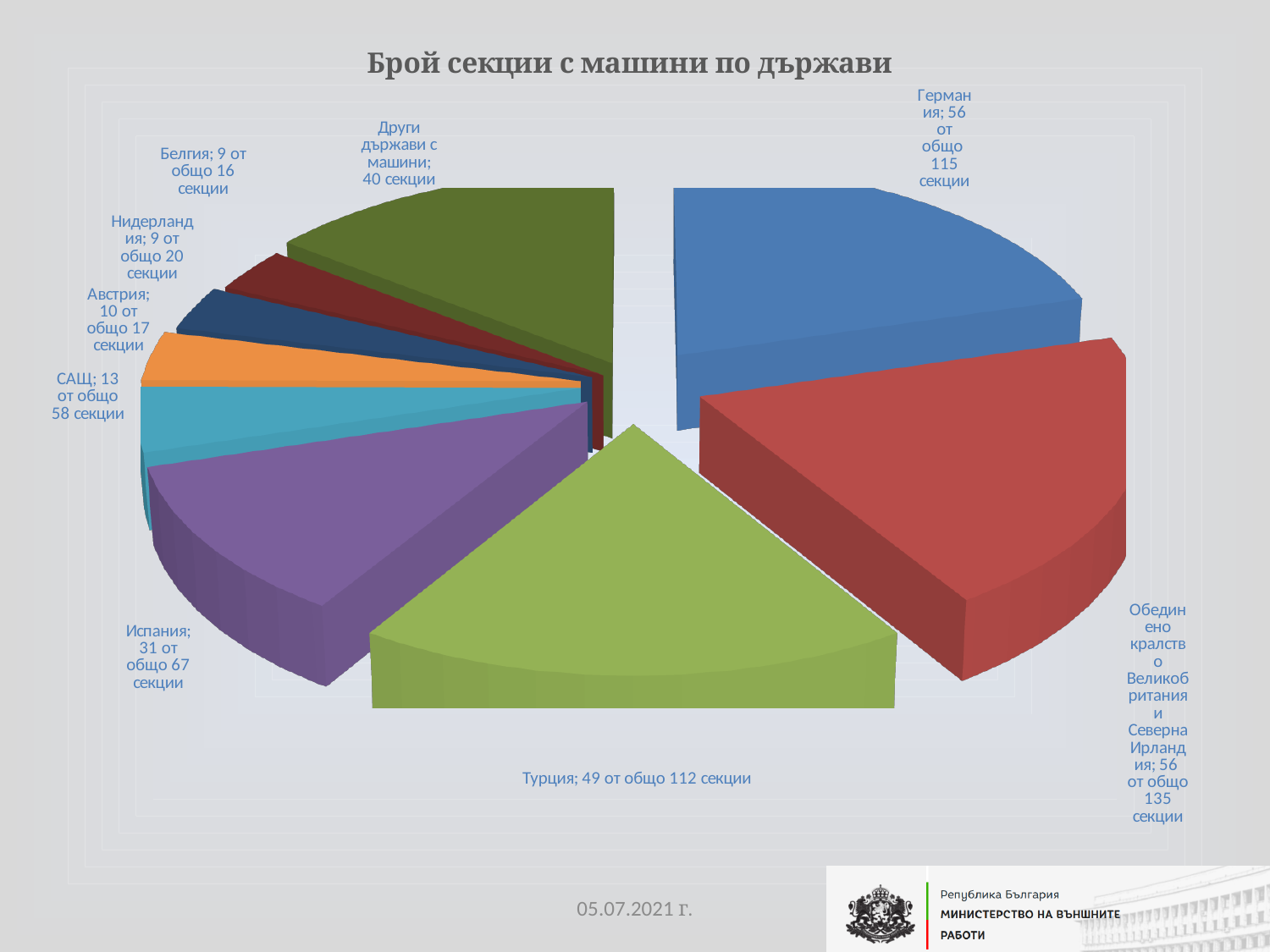
How many sections with machines are shown for Испания? 31 How many sections are shown for Други държави с машини? 40 Which has more sections with machines, Турция or Испания? Турция How many sections with machines are shown for Германия? 56 What is the difference between the sections with machines for Турция and Испания? 18 How many sections with machines are shown for Турция? 49 How many slices does the pie chart have? 9 What is the difference between the sections with machines for Германия and Турция? 7 Out of how many total sections are the 13 sections with machines for САЩ? 58 What is the title of the chart? Брой секции с машини по държави What colour is the slice for Турция? green What kind of chart is shown on the slide? pie chart